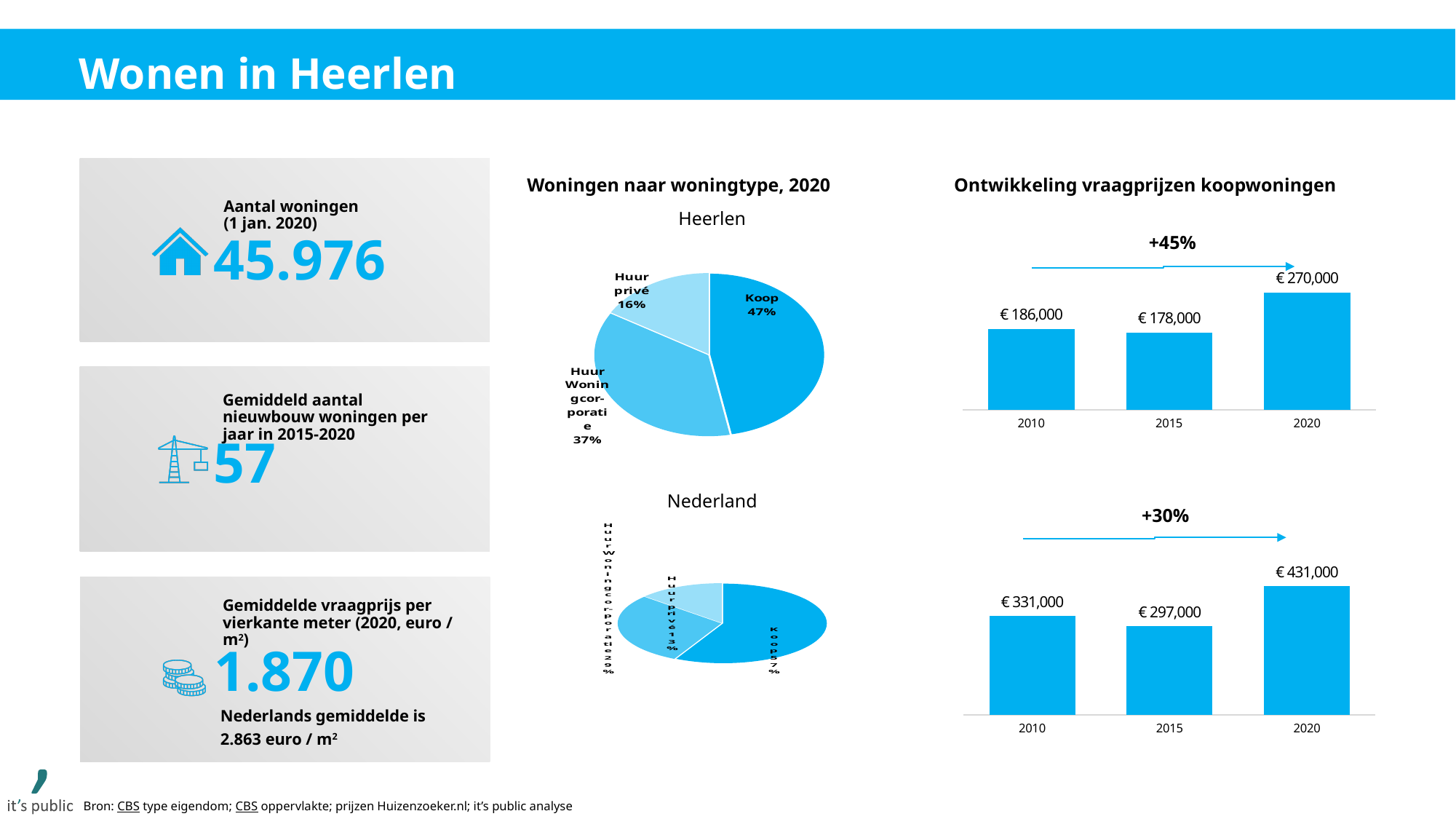
In the bottom bar chart under Ontwikkeling vraagprijzen koopwoningen, what is the value for 2010? € 331,000 In the top bar chart under Ontwikkeling vraagprijzen koopwoningen, what is the value for 2020? € 270,000 In the Heerlen pie chart, which category has the smallest share? Huur privé In the Heerlen pie chart (Woningen naar woningtype, 2020), what share is Koop? 47% In the bottom bar chart under Ontwikkeling vraagprijzen koopwoningen, what percentage increase is shown above the bars? +30% In the top bar chart under Ontwikkeling vraagprijzen koopwoningen, what is the value for 2015? € 178,000 What kind of chart is used for Woningen naar woningtype, 2020 for Heerlen? pie chart In the Heerlen pie chart, what share is Huur privé? 16% In the bottom bar chart under Ontwikkeling vraagprijzen koopwoningen, which year has the lowest value? 2015 In the top bar chart under Ontwikkeling vraagprijzen koopwoningen, what is the difference between 2020 and 2010? € 84,000 In the Heerlen pie chart, which category has the largest share? Koop In the Heerlen pie chart, how many slices are there? 3